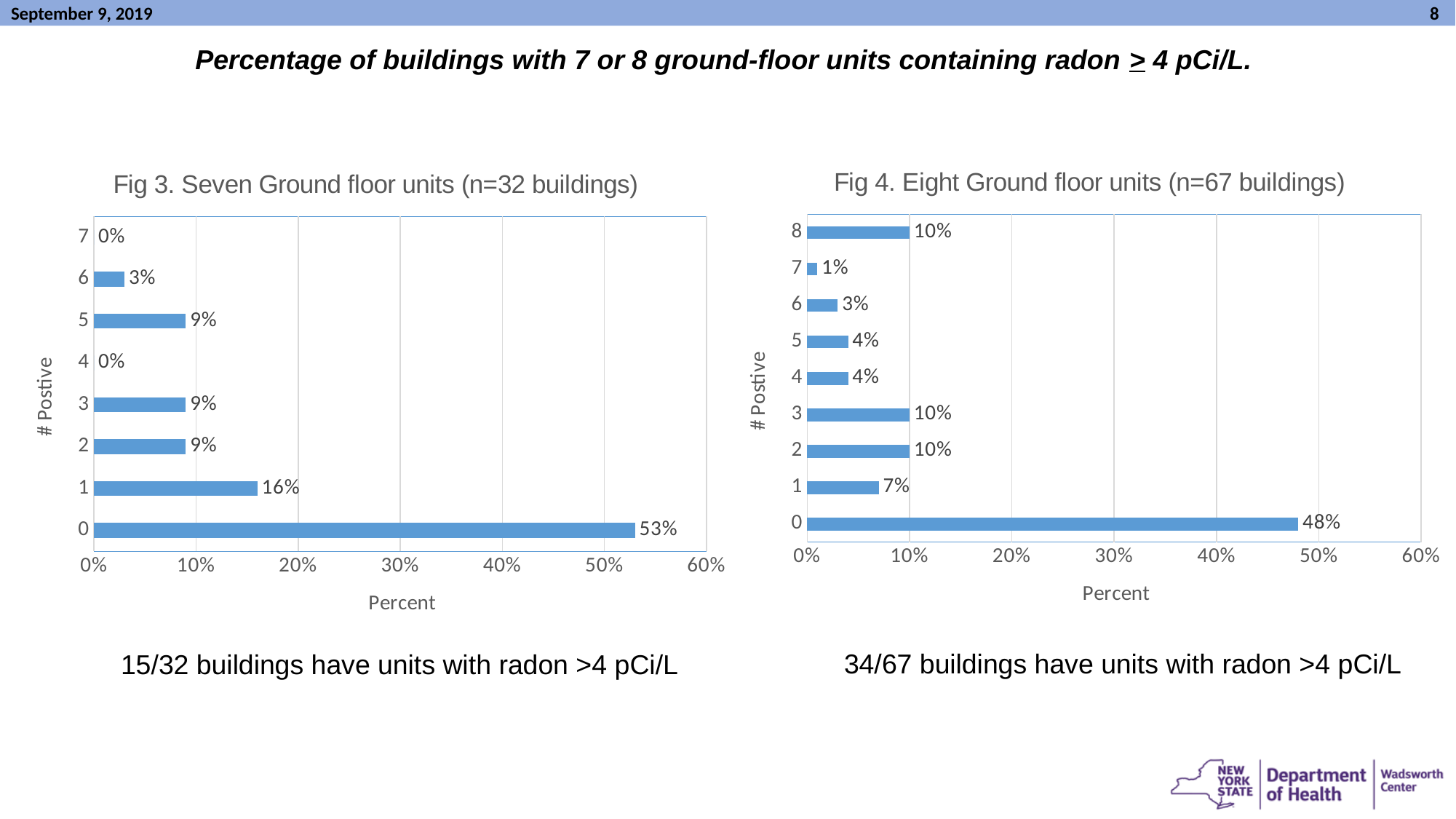
In Fig 3 (Seven Ground floor units), which # Positive category has the highest percentage? 0 In Fig 4 (Eight Ground floor units), which is larger: the percentage for 1 positive unit or for 6 positive units? 1 positive unit In Fig 3 (Seven Ground floor units), is the value for 0 positive units greater or less than 50%? greater What is the x-axis label of Fig 4 (Eight Ground floor units)? Percent In Fig 4 (Eight Ground floor units), what is the difference between the percentage for 0 positive units and the percentage for 1 positive unit? 41% In Fig 3 (Seven Ground floor units), what percentage of buildings have 1 positive unit? 16% How many # Positive categories are shown in Fig 3 (Seven Ground floor units)? 8 In Fig 4 (Eight Ground floor units), what percentage of buildings have 8 positive units? 10% In Fig 3 (Seven Ground floor units), what is the difference between the percentage for 0 positive units and the percentage for 1 positive unit? 37% What type of chart is Fig 3 (Seven Ground floor units)? Bar chart How many # Positive categories are shown in Fig 4 (Eight Ground floor units)? 9 In Fig 4 (Eight Ground floor units), which # Positive category has the lowest percentage? 7